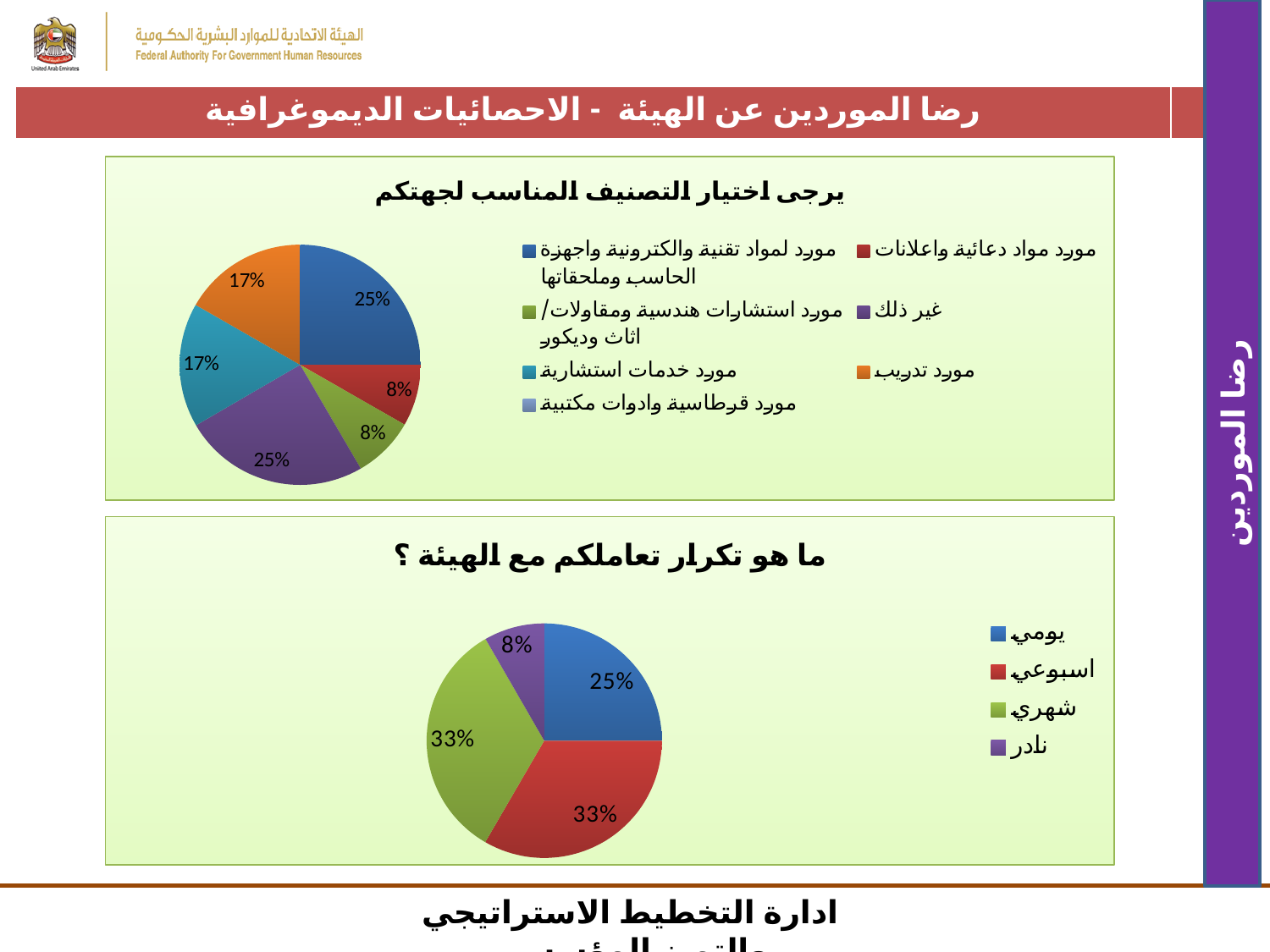
In the bottom chart "ما هو تكرار تعاملكم مع الهيئة ؟", what share is labelled for "نادر"? 8% In the top chart "يرجى اختيار التصنيف المناسب لجهتكم", what share is labelled for "مورد تدريب"? 17% In the top chart "يرجى اختيار التصنيف المناسب لجهتكم", what share is labelled for "غير ذلك"? 25% In the top chart "يرجى اختيار التصنيف المناسب لجهتكم", what share is labelled for "مورد مواد دعائية واعلانات"? 8% In the bottom chart "ما هو تكرار تعاملكم مع الهيئة ؟", which category has the smallest slice? نادر What kind of chart is the top chart titled "يرجى اختيار التصنيف المناسب لجهتكم"? pie chart How many entries does the legend of the top chart "يرجى اختيار التصنيف المناسب لجهتكم" list? 7 In the bottom chart "ما هو تكرار تعاملكم مع الهيئة ؟", how many percentage points larger is "اسبوعي" than "نادر"? 25 How many entries does the legend of the bottom chart "ما هو تكرار تعاملكم مع الهيئة ؟" list? 4 In the top chart "يرجى اختيار التصنيف المناسب لجهتكم", which is larger: "مورد خدمات استشارية" or "مورد مواد دعائية واعلانات"? مورد خدمات استشارية What is the title of the bottom chart on the slide? ما هو تكرار تعاملكم مع الهيئة ؟ In the bottom chart "ما هو تكرار تعاملكم مع الهيئة ؟", what share is labelled for "يومي"? 25%